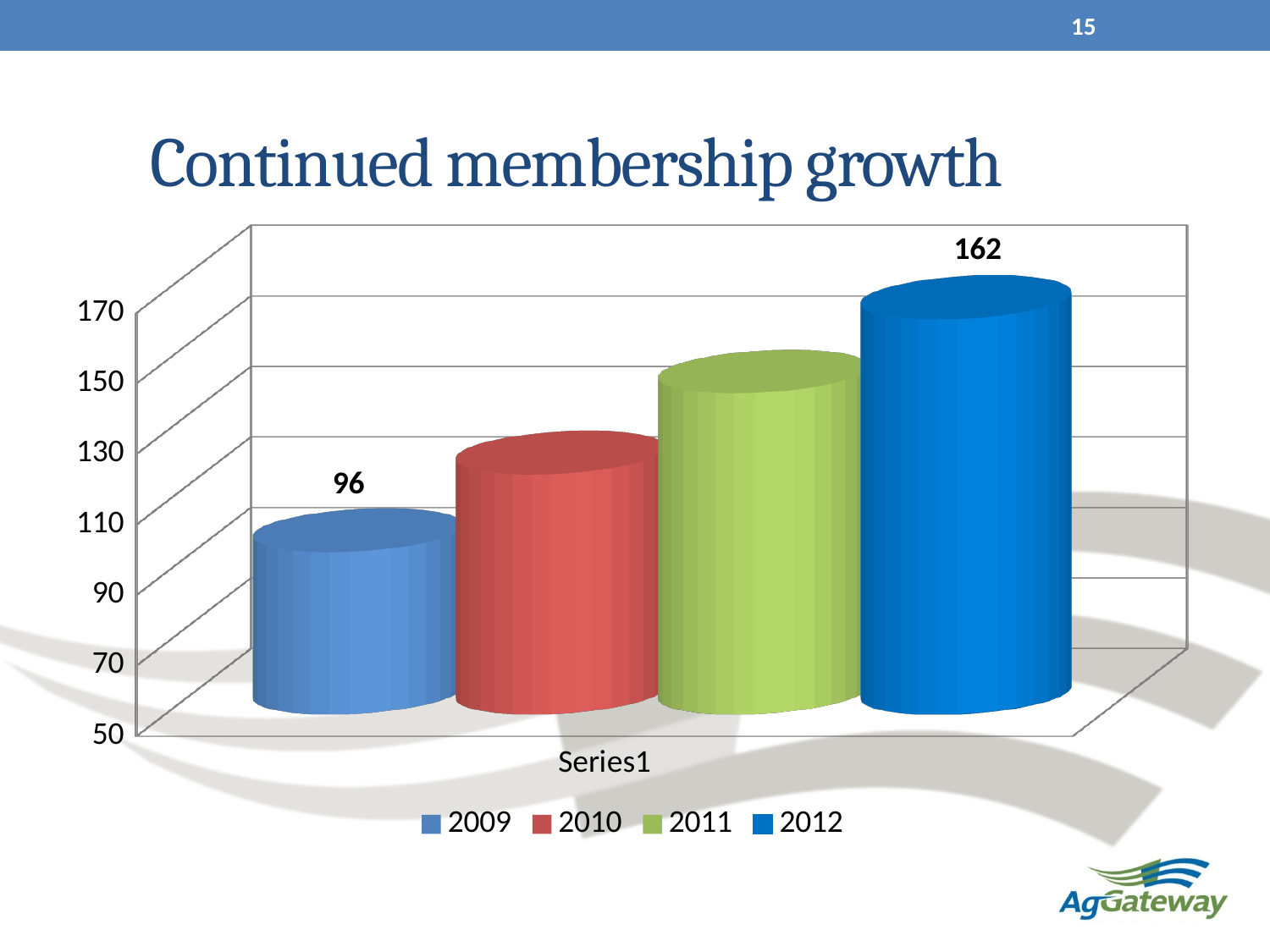
Which year has the highest value? 2012 What is the value for 2012? 162 Is the value for 2011 greater or less than 170? less How many series does the legend list? 4 Is the value for 2010 greater or less than 90? greater What is the difference between the values for 2012 and 2009? 66 Do the values rise or fall from 2009 to 2012? rise What is the value for 2009? 96 Which year has the lowest value? 2009 What kind of chart is shown on the slide? bar chart Which is larger, the value for 2011 or the value for 2010? 2011 What is the title of the slide? Continued membership growth